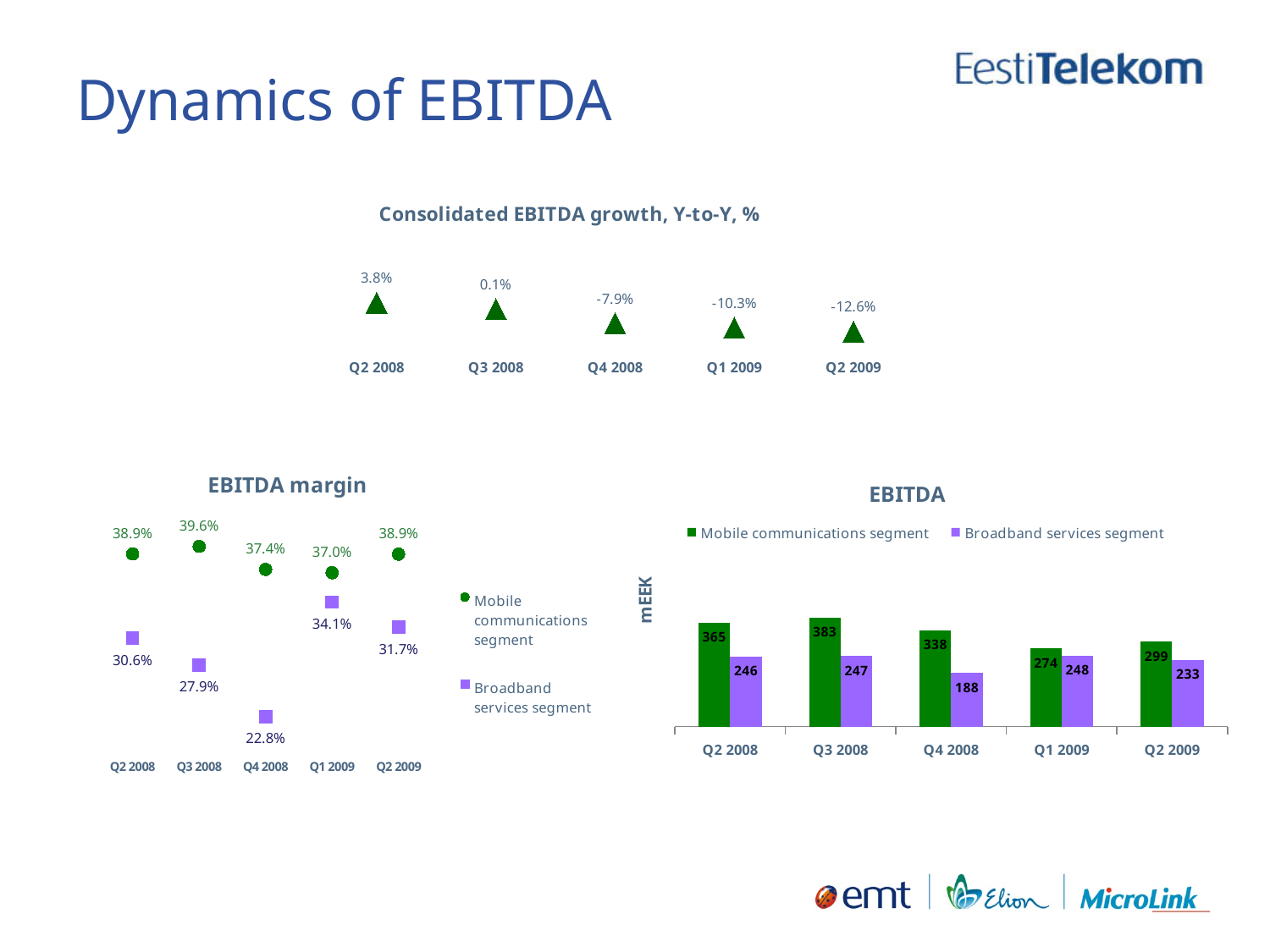
In the 'EBITDA margin' chart, what is the Broadband services segment margin for Q4 2008? 22.8% What kind of chart is the 'EBITDA' chart? bar chart In the 'Consolidated EBITDA growth, Y-to-Y, %' chart, which quarter has the lowest value? Q2 2009 In the 'Consolidated EBITDA growth, Y-to-Y, %' chart, how many quarters are plotted? 5 In the 'EBITDA margin' chart, which quarter has the highest Mobile communications segment margin? Q3 2008 In the 'EBITDA' chart, which quarter has the lowest Broadband services segment value? Q4 2008 In the 'EBITDA' chart, what is the difference between the Mobile communications segment and Broadband services segment values in Q1 2009? 26 In the 'EBITDA margin' chart, how many series does the legend list? 2 In the 'EBITDA' chart, what is the Mobile communications segment value for Q3 2008? 383 In the 'Consolidated EBITDA growth, Y-to-Y, %' chart, do the values rise or fall from Q2 2008 to Q2 2009? fall In the 'Consolidated EBITDA growth, Y-to-Y, %' chart, what is the value for Q4 2008? -7.9% In the 'EBITDA margin' chart, what is the difference between the Mobile communications segment and Broadband services segment margins in Q2 2009? 7.2%